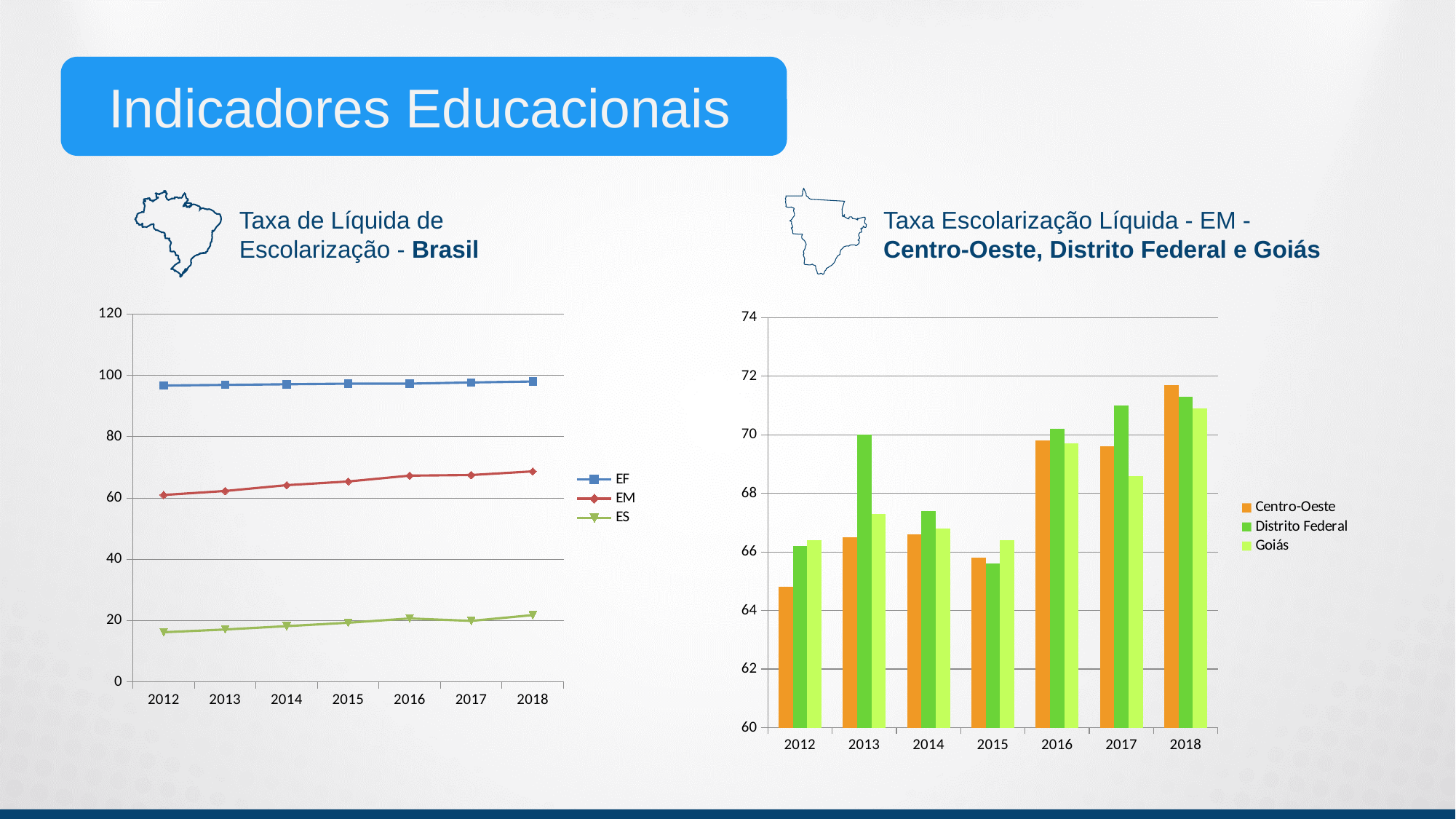
In the right chart (Centro-Oeste, Distrito Federal e Goiás), which is larger in 2013: Centro-Oeste or Distrito Federal? Distrito Federal In the left chart (Brasil), is the value for EM in 2018 greater or less than 60? greater What kind of chart is the left chart, 'Taxa de Líquida de Escolarização - Brasil'? line chart In the right chart (Centro-Oeste, Distrito Federal e Goiás), how many years are shown on the x axis? 7 In the left chart (Brasil), how many series does the legend list? 3 What kind of chart is the right chart, 'Taxa Escolarização Líquida - EM - Centro-Oeste, Distrito Federal e Goiás'? bar chart In the left chart (Brasil), is the value for ES in 2012 greater or less than 20? less In the left chart (Brasil), which series has the highest values across all years? EF In the left chart (Brasil), which series has the lowest values across all years? ES In the left chart (Brasil), does the EM series rise or fall from 2012 to 2018? rise In the right chart (Centro-Oeste, Distrito Federal e Goiás), is the value for Centro-Oeste in 2012 greater or less than 66? less In the right chart (Centro-Oeste, Distrito Federal e Goiás), in which year is the Centro-Oeste bar highest? 2018